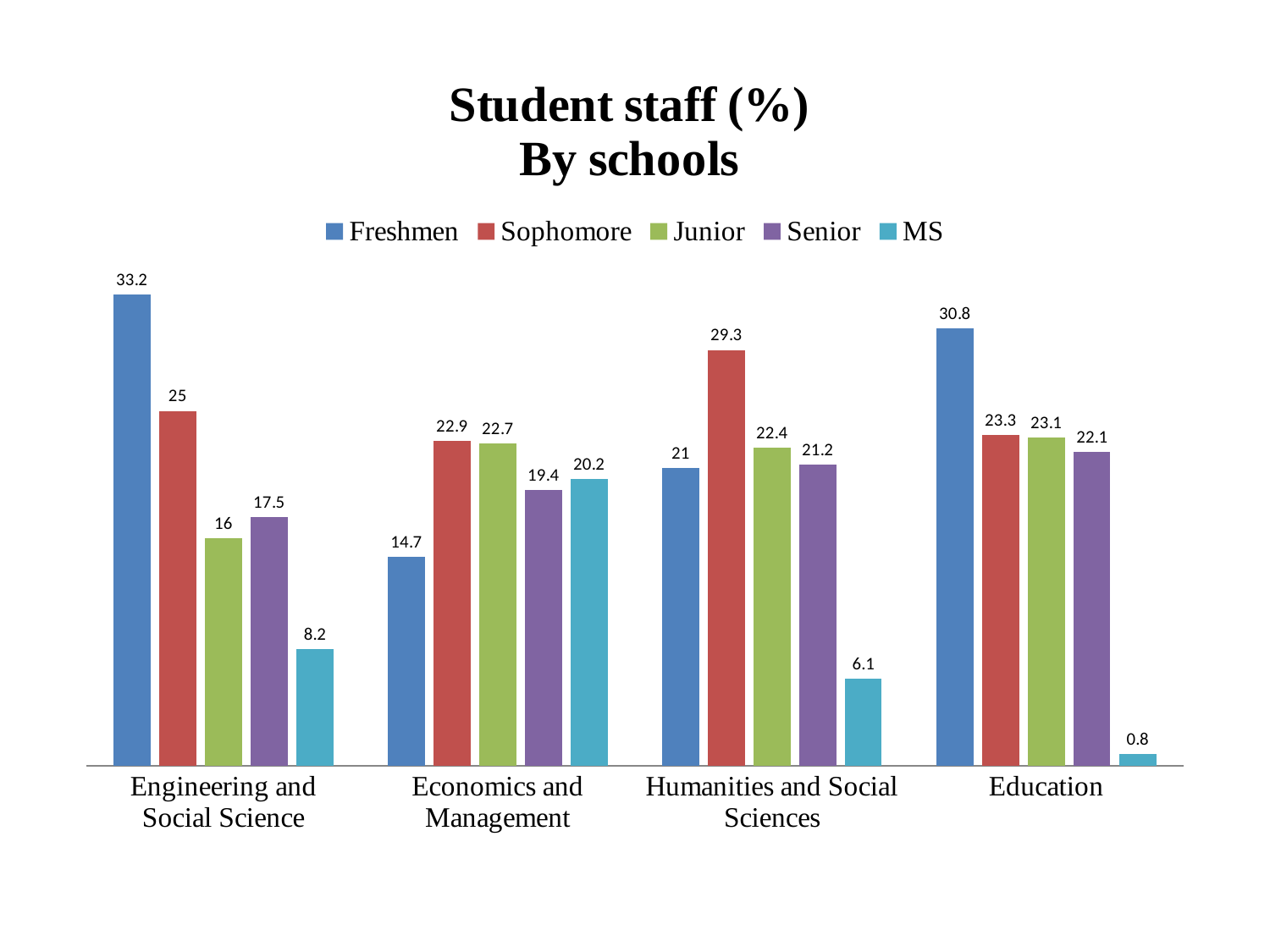
What is the MS value for Education? 0.8 Which school has the highest Freshmen value? Engineering and Social Science What is the difference between the Freshmen and Sophomore values for Engineering and Social Science? 8.2 How many series does the legend list? 5 Which series is shown in blue in the legend? Freshmen Which school has the lowest MS value? Education What is the Sophomore value for Humanities and Social Sciences? 29.3 Which is larger for Economics and Management: the Freshmen value or the MS value? MS What kind of chart is shown on the slide? Bar chart How many schools are shown on the x axis? 4 What is the Freshmen value for Engineering and Social Science? 33.2 What is the title of the chart? Student staff (%) By schools